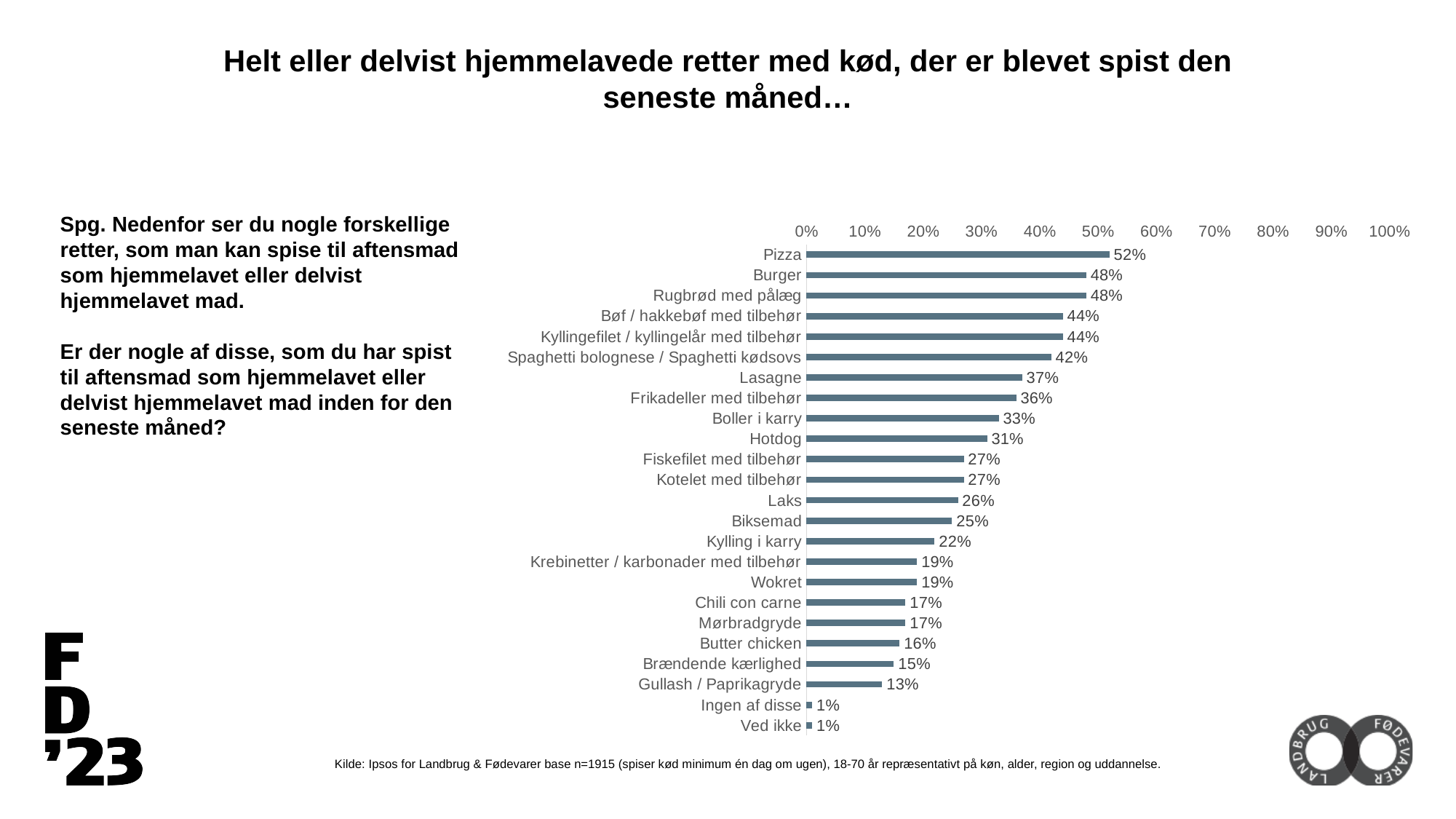
What percentage is shown for Gullash / Paprikagryde? 13% What is the highest value shown on the percentage axis? 100% What is the difference between the values for Hotdog and Boller i karry? 2% What is the value for Ved ikke? 1% What is the difference between the values for Pizza and Burger? 4% What percentage is shown for Pizza? 52% How many categories are plotted in the chart? 24 What is the value for Lasagne? 37% What kind of chart is shown on the slide? Bar chart Which is larger, the value for Kylling i karry or the value for Butter chicken? Kylling i karry Which is larger, the value for Frikadeller med tilbehør or the value for Biksemad? Frikadeller med tilbehør Which dish has the highest percentage? Pizza